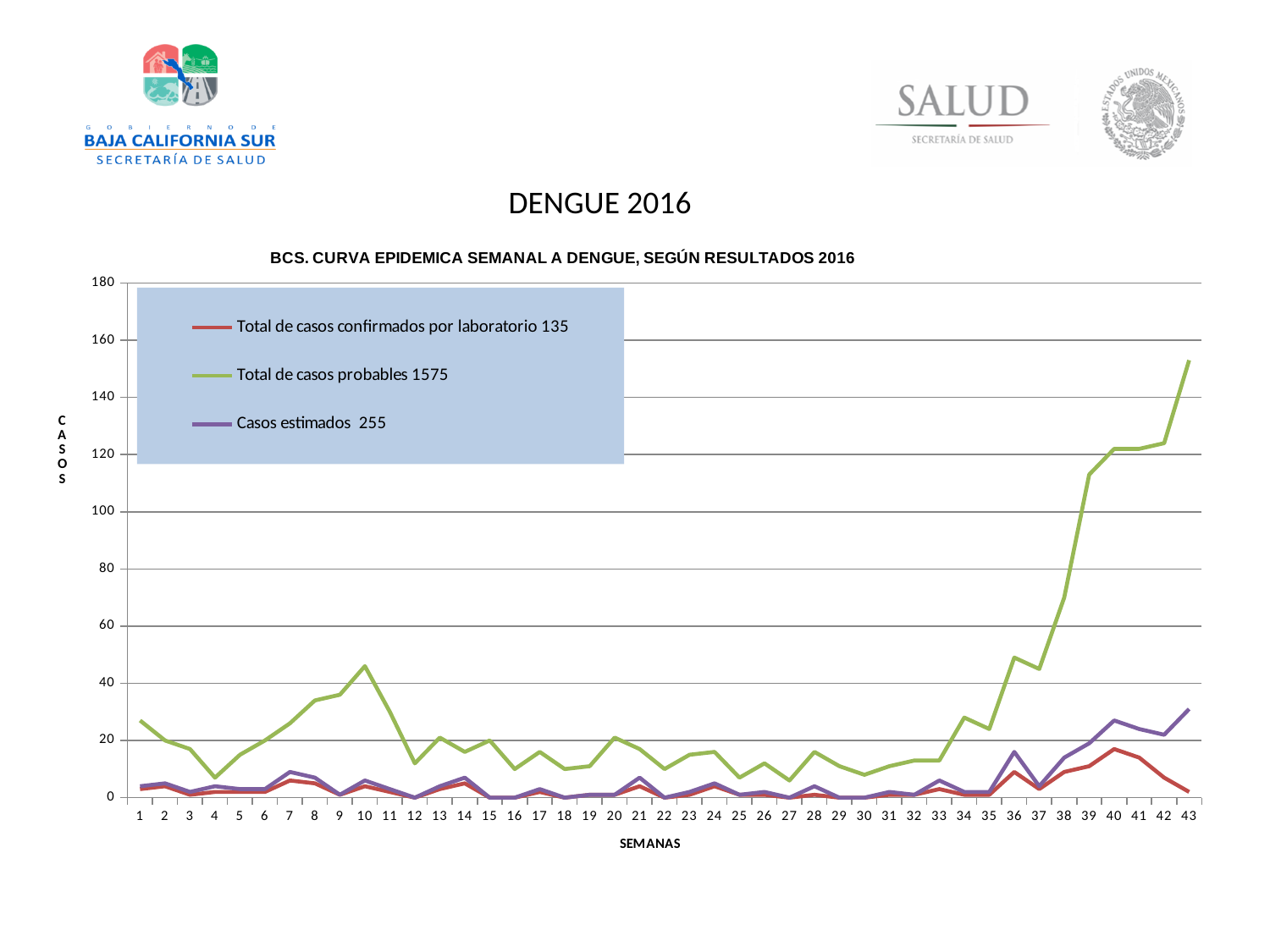
At week 43, which is larger: 'Total de casos probables' or 'Casos estimados'? Total de casos probables How many series does the legend list? 3 Is the value of 'Casos estimados' at week 43 greater or less than 20? greater What is the title of the chart? BCS. CURVA EPIDEMICA SEMANAL A DENGUE, SEGÚN RESULTADOS 2016 At which week does 'Total de casos probables' reach its highest value? 43 What total is given in the legend for 'Total de casos probables'? 1575 Is the value of 'Total de casos probables' at week 43 greater or less than 140? greater What kind of chart is shown on the slide? line chart Is the value of 'Total de casos probables' at week 10 greater or less than 40? greater Does 'Total de casos probables' rise or fall from week 33 to week 43? rise How many weeks are plotted along the x axis? 43